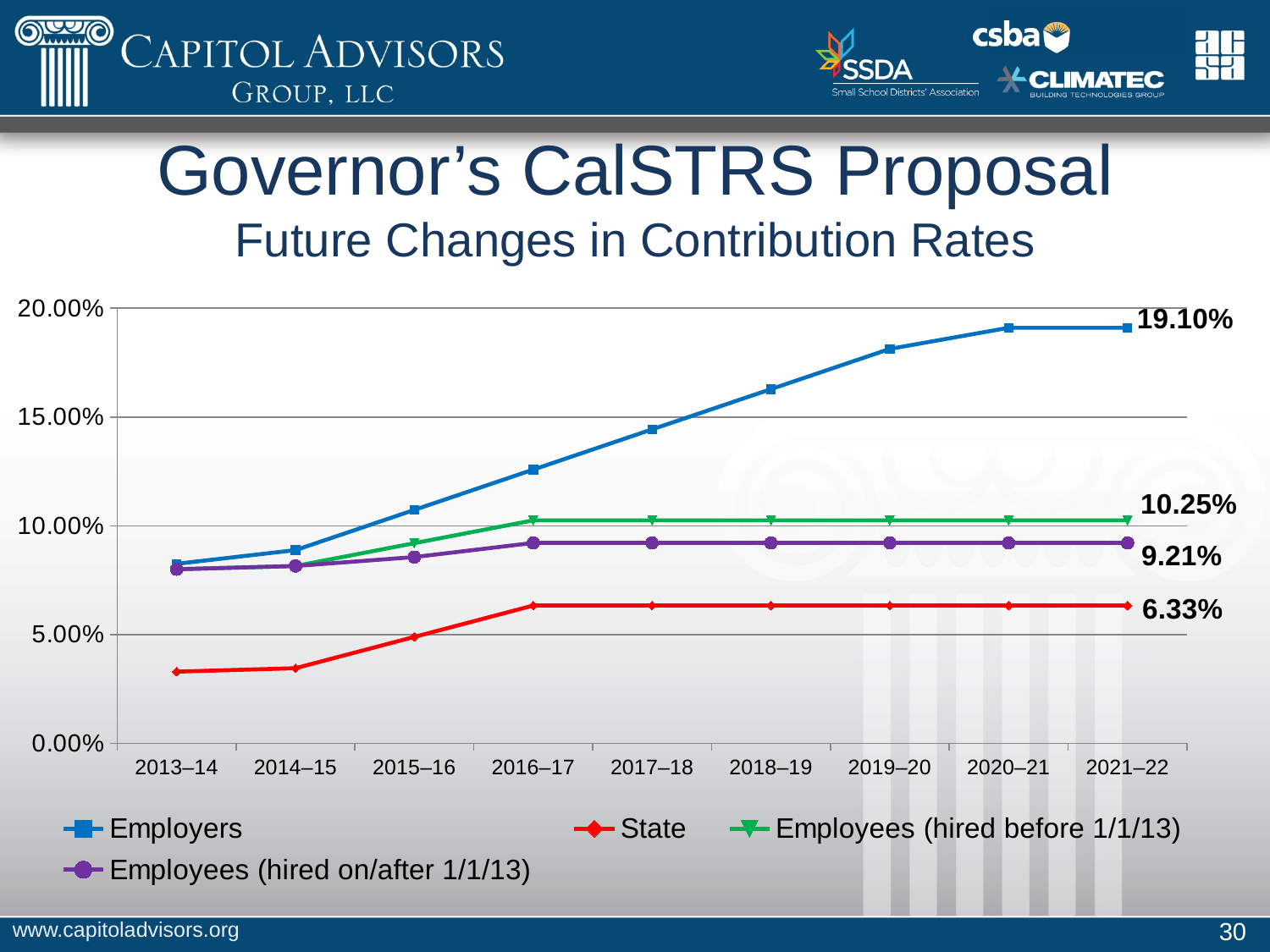
Is the Employers rate in 2018–19 greater or less than 15.00%? greater How many fiscal years are shown on the x axis? 9 Is the Employers rate in 2013–14 greater or less than 10.00%? less What is the State contribution rate in 2021–22? 6.33% How many series does the legend list? 4 Which series has the highest contribution rate in 2021–22? Employers Which series has the lowest contribution rate in 2021–22? State What is the contribution rate for Employees (hired on/after 1/1/13) in 2021–22? 9.21% What is the difference between the Employers rate and the State rate in 2021–22? 12.77% What is the Employers contribution rate in 2021–22? 19.10% What is the contribution rate for Employees (hired before 1/1/13) in 2021–22? 10.25% In 2021–22, which is larger: the rate for Employees (hired before 1/1/13) or the rate for Employees (hired on/after 1/1/13)? Employees (hired before 1/1/13)